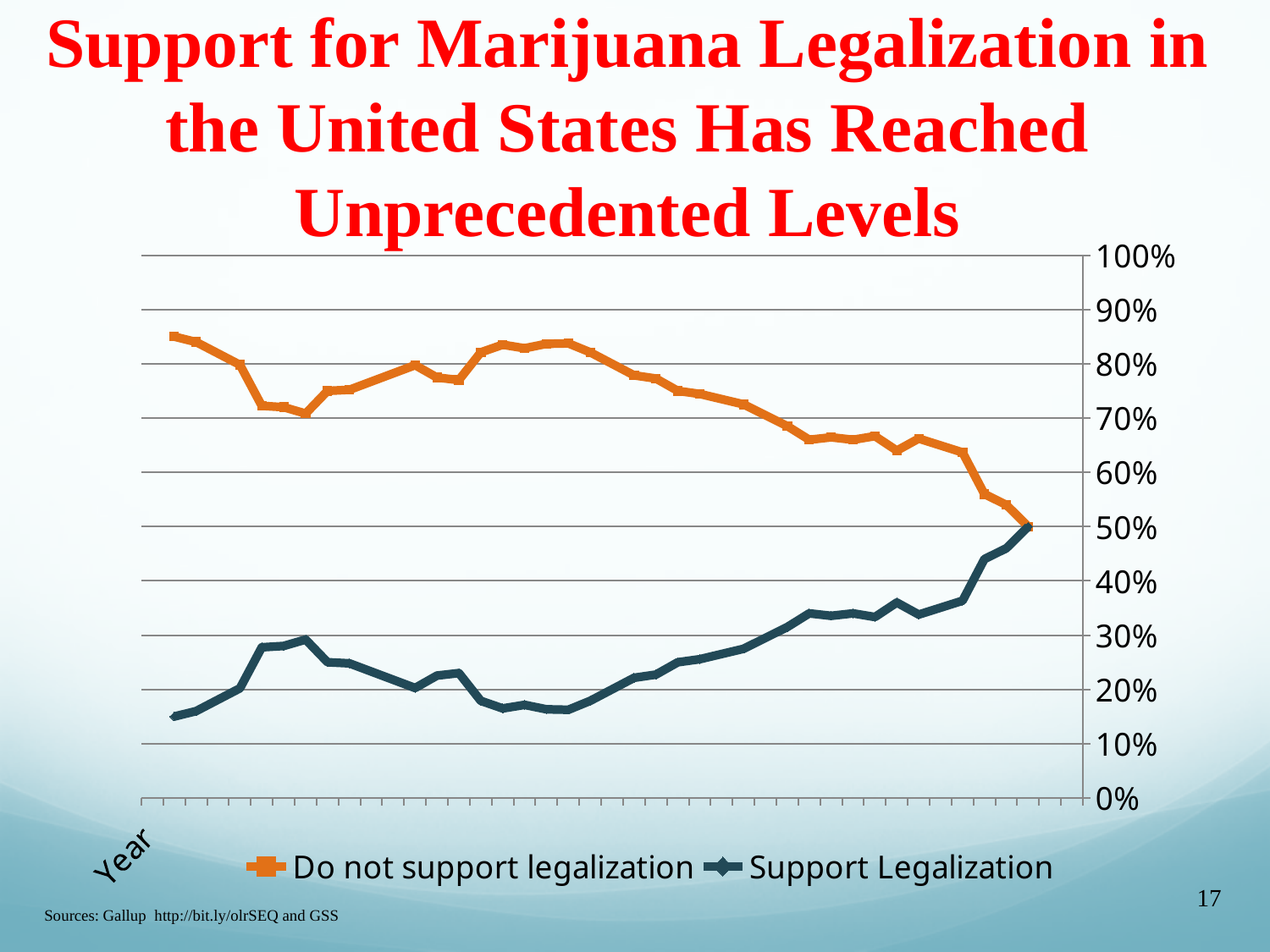
Is the first value of the 'Support Legalization' line greater or less than 20%? less Is the first value of the 'Do not support legalization' line greater or less than 80%? greater Which colour is used for the 'Support Legalization' line? dark teal Is the last value of the 'Support Legalization' line greater or less than 40%? greater At the left end of the chart, which series has the higher value: 'Do not support legalization' or 'Support Legalization'? Do not support legalization What is the label on the horizontal axis of the chart? Year How many series does the chart's legend list? 2 Does the 'Do not support legalization' line rise or fall overall from left to right? fall What are the two series named in the legend? Do not support legalization; Support Legalization What kind of chart is shown on the slide? line chart Does the 'Support Legalization' line rise or fall overall from left to right? rise